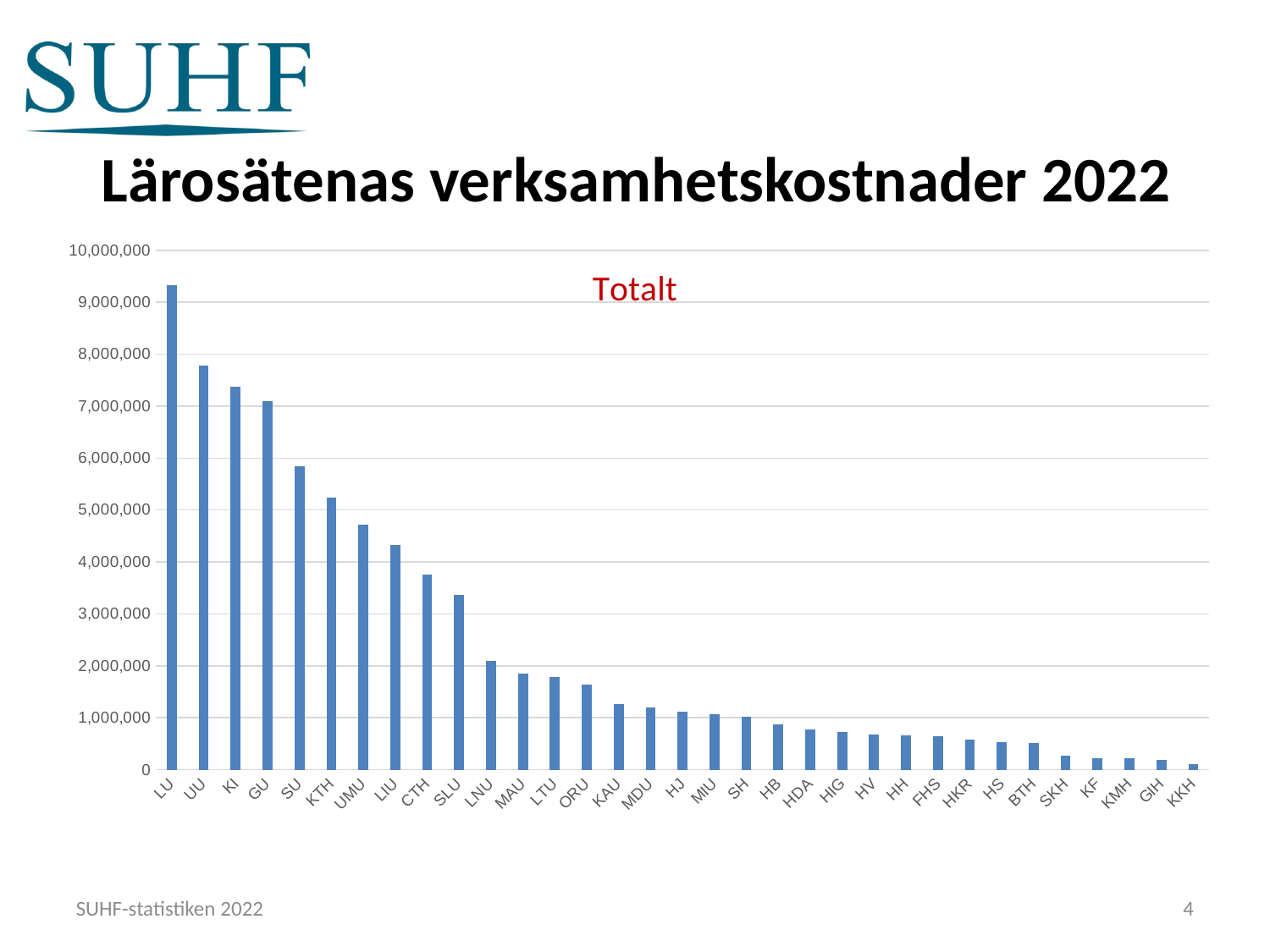
Is the value for UMU greater or less than 5,000,000? less Do the values rise or fall moving from left to right along the x axis? fall Is the value for LU greater or less than 9,000,000? greater Is the value for SLU greater or less than 3,000,000? greater Which has the larger value, UU or KI? UU How many institutions are shown along the x axis? 33 Which institution has the highest value in the chart? LU Which institution has the lowest value in the chart? KKH What is the title of the chart? Lärosätenas verksamhetskostnader 2022 What kind of chart is shown on the slide? bar chart